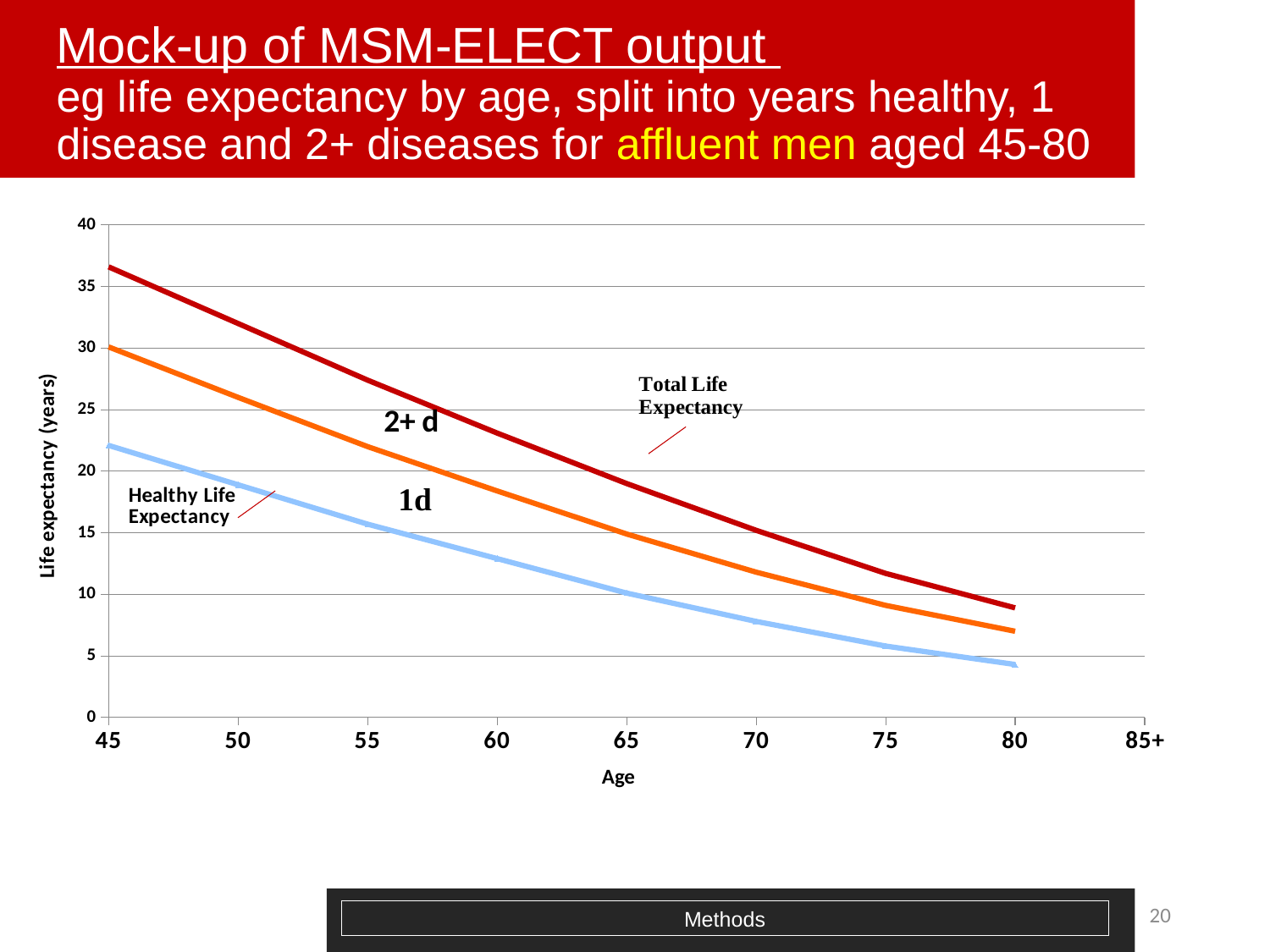
Do the life expectancy values rise or fall as age increases along the x axis? fall Is the Healthy Life Expectancy value at age 45 greater or less than 20? greater Is the Total Life Expectancy value at age 45 greater or less than 35? greater Is the Total Life Expectancy value at age 75 greater or less than 10? greater What kind of chart is shown on the slide? line chart How many lines are plotted on the chart? 3 What is the label of the x axis? Age What is the label of the y axis? Life expectancy (years) Which line is highest across all ages: Total Life Expectancy or Healthy Life Expectancy? Total Life Expectancy